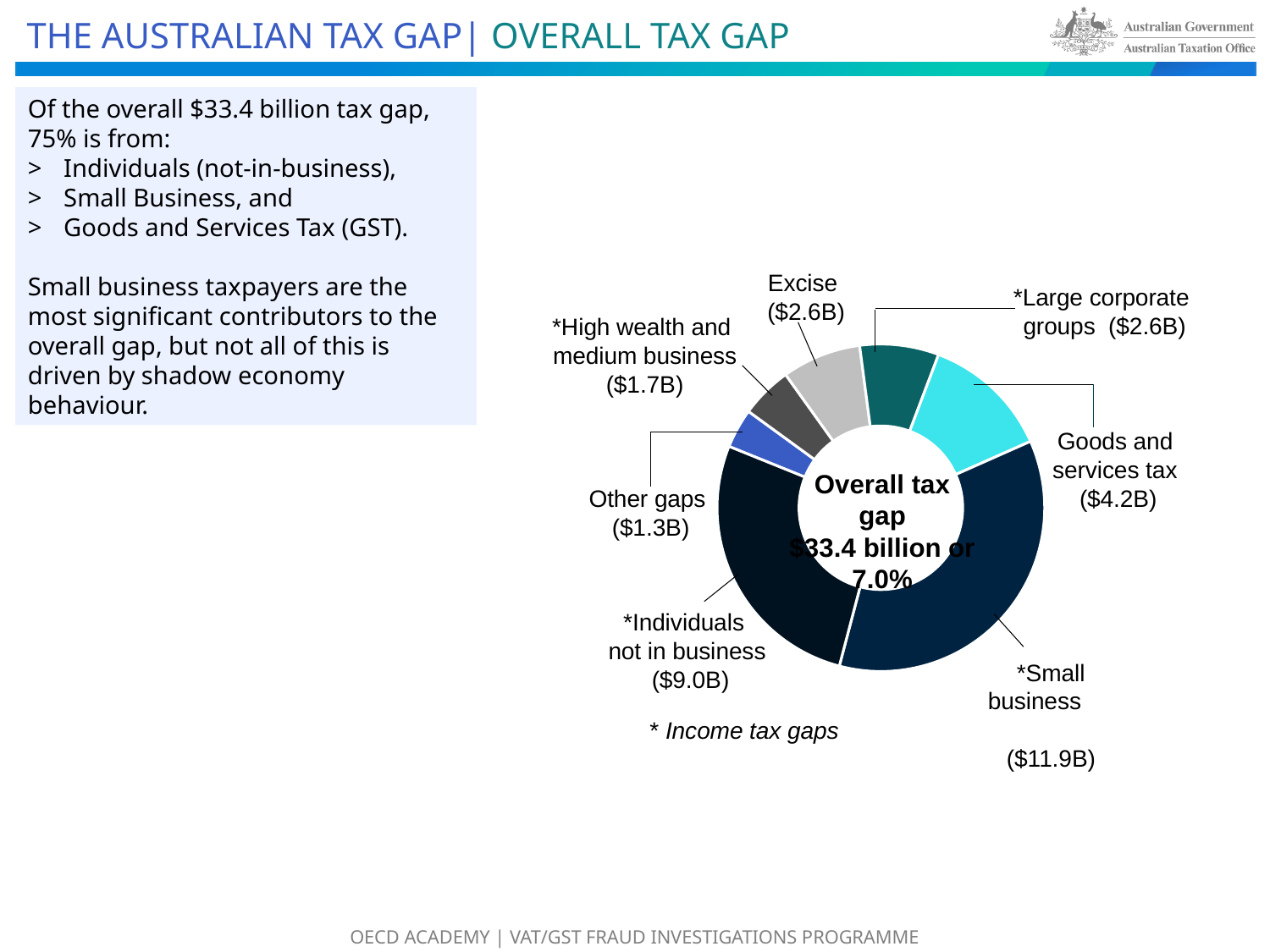
What is the value for Other gaps in the tax gap chart? $1.3B How many segments does the tax gap chart have? 7 Which segment of the tax gap chart has the largest value? Small business Which is larger in the tax gap chart: Goods and services tax or Excise? Goods and services tax What overall tax gap figure is printed in the centre of the chart? $33.4 billion or 7.0% What kind of chart is shown on the slide? Pie chart (donut) What is the value for Individuals not in business in the tax gap chart? $9.0B What is the difference between the Small business gap and the Individuals not in business gap? $2.9B Which segment of the tax gap chart has the smallest value? Other gaps What is the value for High wealth and medium business in the tax gap chart? $1.7B What is the value for Goods and services tax in the tax gap chart? $4.2B What is the value for Small business in the tax gap chart? $11.9B